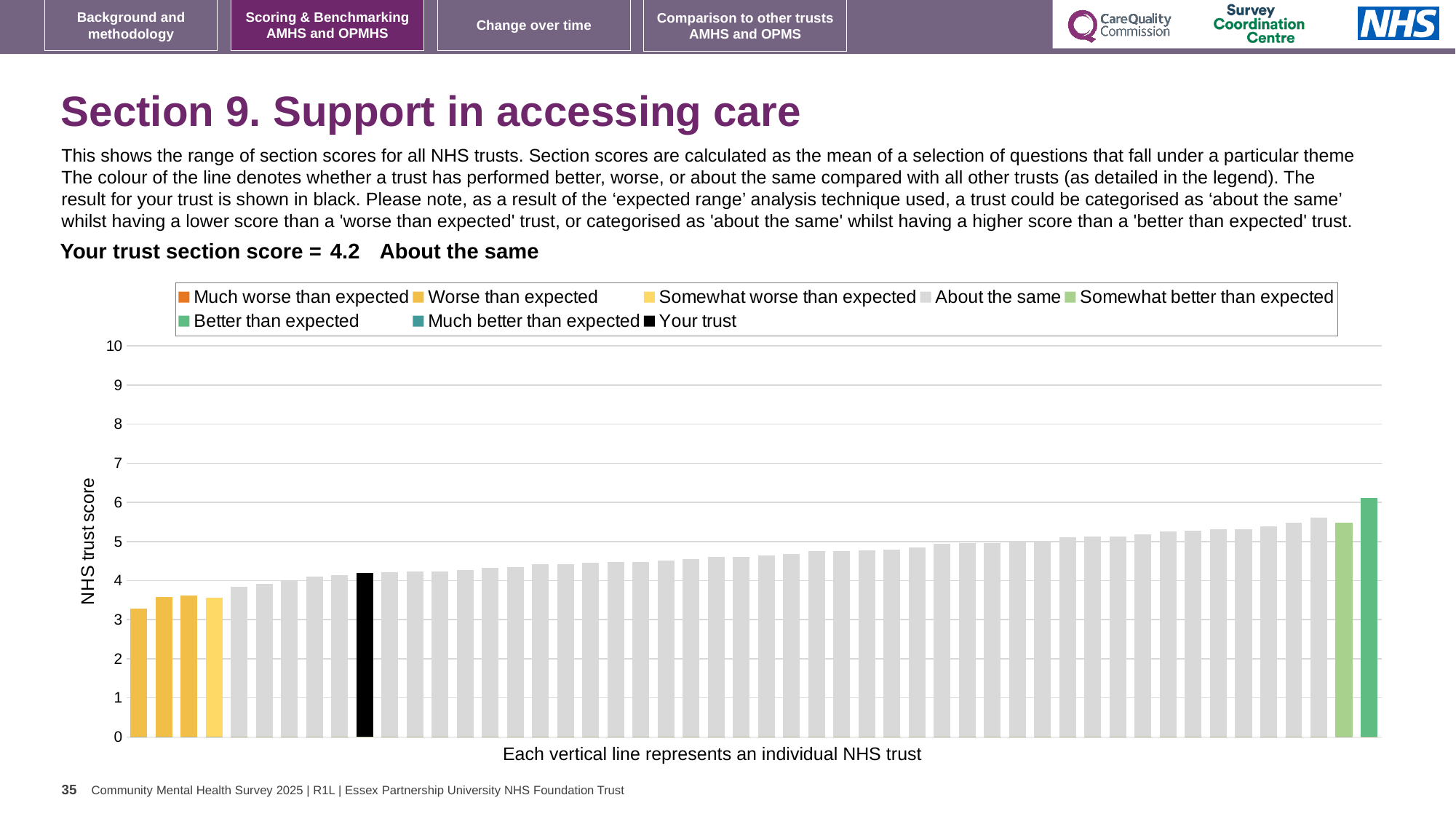
What is the label on the vertical axis of the chart? NHS trust score Do the bar values rise or fall from left to right along the x axis? rise Is the value for your trust (the black bar) greater or less than 5? less What is the section score for your trust? 4.2 Is the value for the highest bar greater or less than 7? less What kind of chart is shown on the slide? bar chart What colour is the bar representing your trust? black Is the value for your trust (the black bar) greater or less than 4? greater How many entries does the chart legend list? 8 How is your trust's section score categorised compared with other trusts? About the same